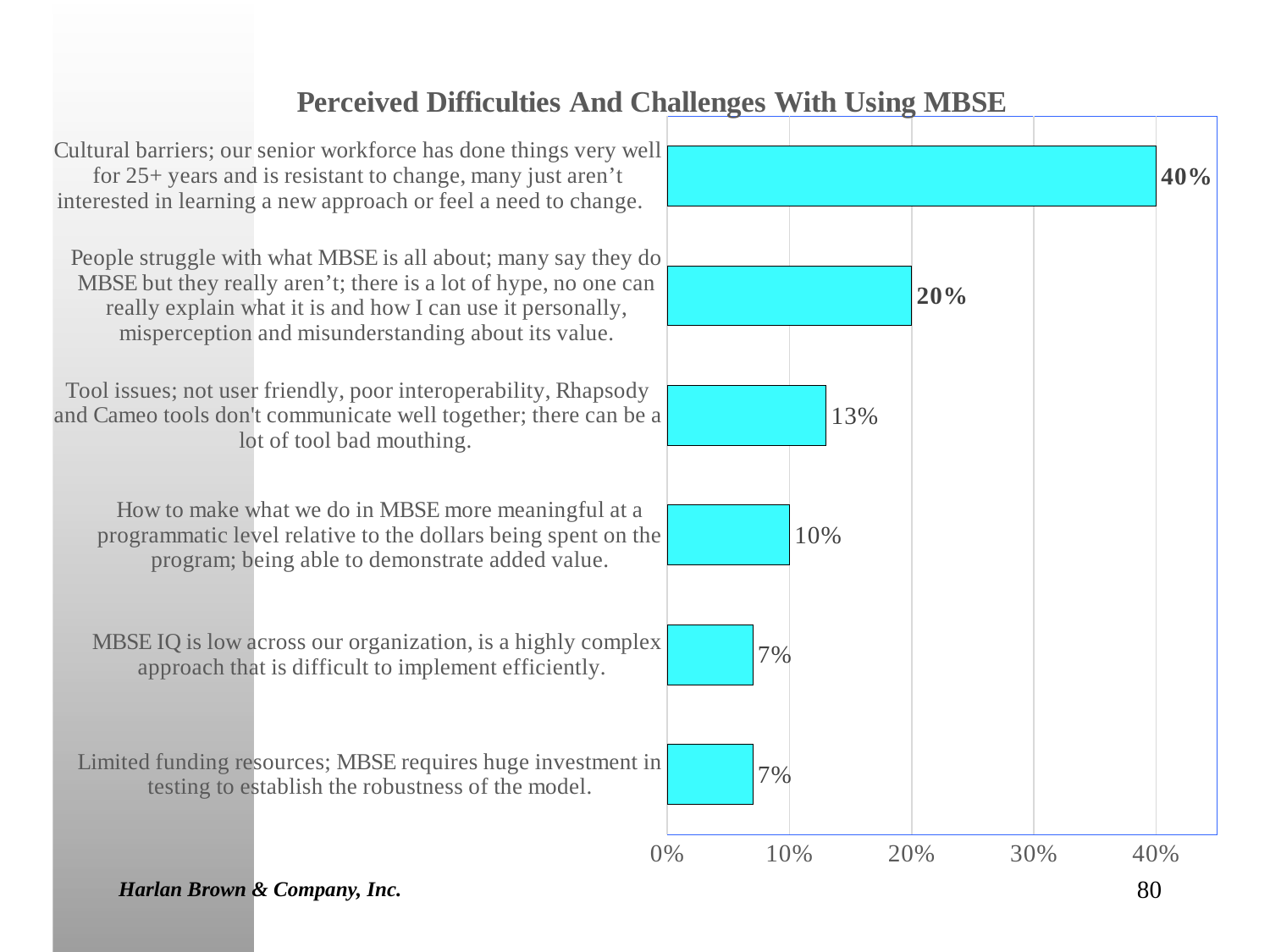
What is the difference between the 'Cultural barriers' value and the 'People struggle with what MBSE is all about' value? 20% What is the value for the 'Tool issues' category? 13% What is the value for the 'Cultural barriers' category? 40% What is the value for 'How to make what we do in MBSE more meaningful at a programmatic level'? 10% What kind of chart is shown on the slide? bar chart Is the value for 'People struggle with what MBSE is all about' greater or less than 10%? greater What is the value for 'Limited funding resources'? 7% What is the title of the chart? Perceived Difficulties And Challenges With Using MBSE Which category has the highest value? Cultural barriers; our senior workforce has done things very well for 25+ years and is resistant to change How many categories are shown in the chart? 6 Which is larger: the value for 'Tool issues' or the value for 'MBSE IQ is low across our organization'? Tool issues What is the highest value shown on the x axis? 40%